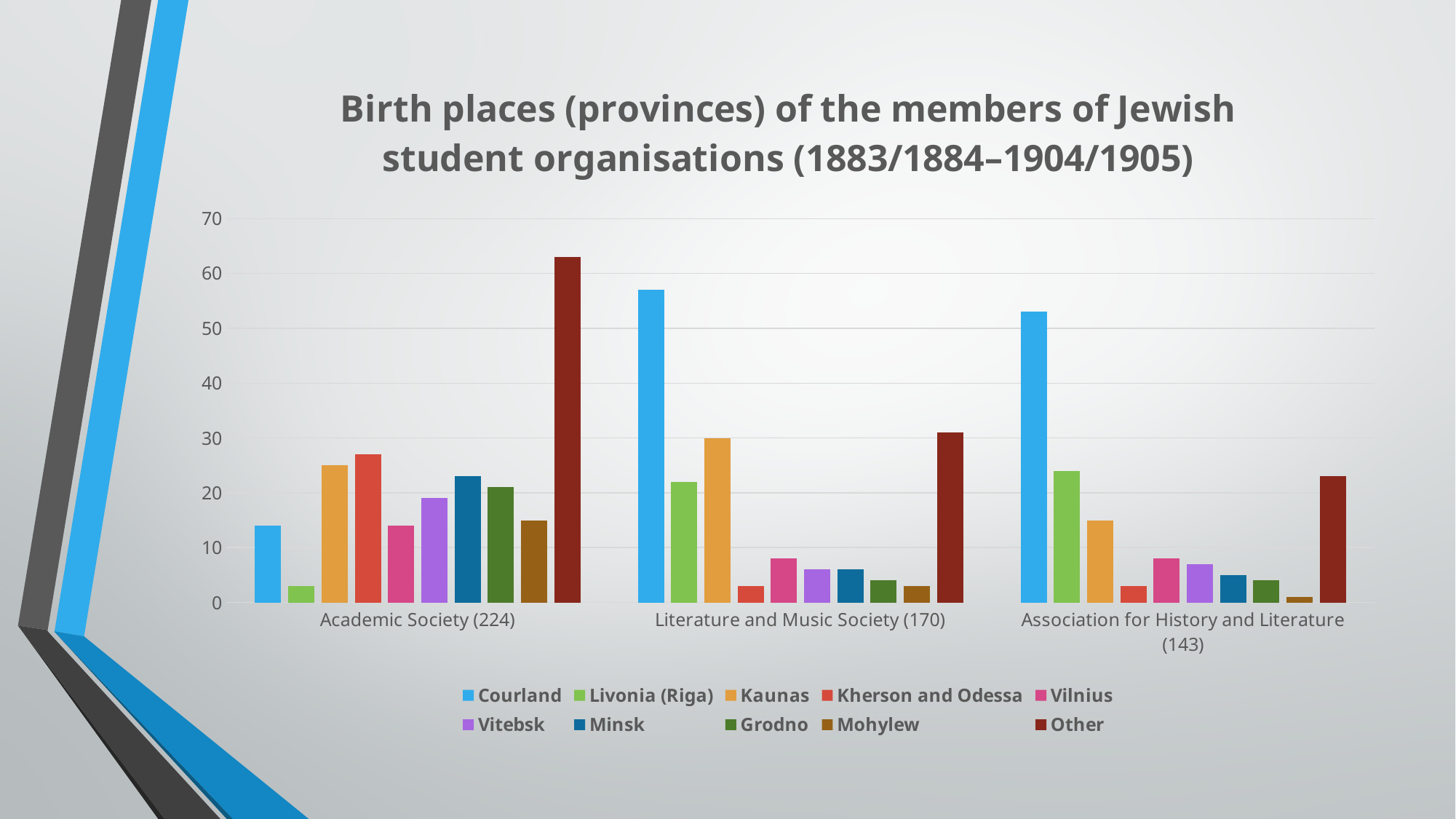
What kind of chart is shown on the slide? Bar chart Is the value for Other in the Academic Society (224) greater or less than 60? greater Which has the larger Livonia (Riga) value: the Academic Society (224) or the Literature and Music Society (170)? Literature and Music Society (170) How many series does the legend list? 10 Which has the larger Courland value: the Academic Society (224) or the Association for History and Literature (143)? Association for History and Literature (143) What is the title of the chart? Birth places (provinces) of the members of Jewish student organisations (1883/1884–1904/1905) How many student organisations (categories) are shown on the x axis? 3 Is the value for Kaunas in the Literature and Music Society (170) greater or less than 20? greater Is the value for Courland in the Literature and Music Society (170) greater or less than 50? greater For the Association for History and Literature (143), which birth-place series has the lowest bar? Mohylew For the Literature and Music Society (170), which birth-place series has the highest bar? Courland For the Academic Society (224), which birth-place series has the highest bar? Other